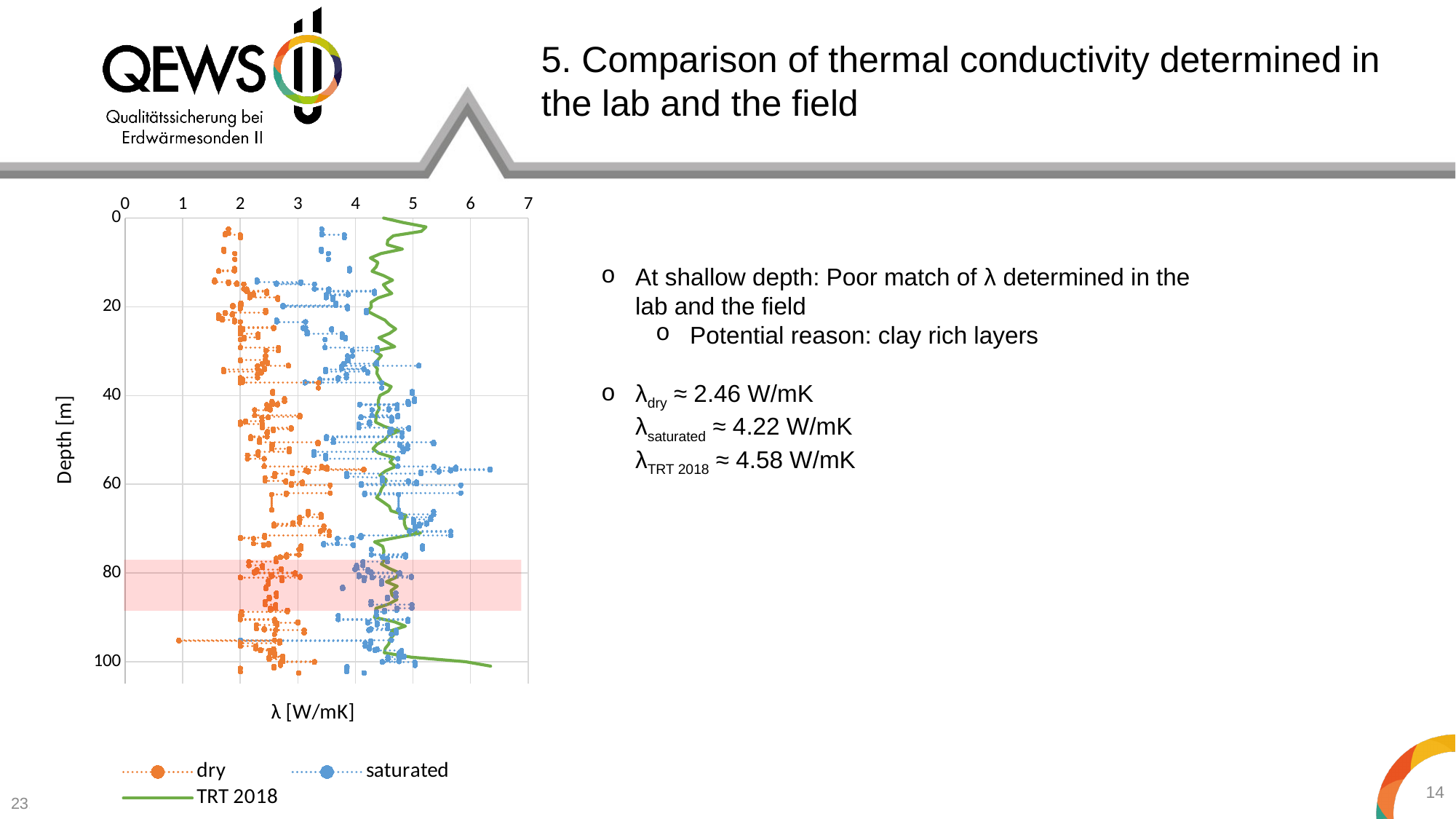
What is the label of the chart's horizontal axis? λ [W/mK] How many series does the chart legend list? 3 Is the saturated value near 100 m depth greater or less than 3? greater What are the series names listed in the chart legend? dry, saturated, TRT 2018 Which series generally has larger λ values, dry or saturated? saturated Which series is drawn as a solid green line, dry, saturated or TRT 2018? TRT 2018 Is the dry value near 0 m depth greater or less than 3? less Is the dry value near 80 m depth greater or less than 4? less What kind of chart is shown on the slide? scatter chart